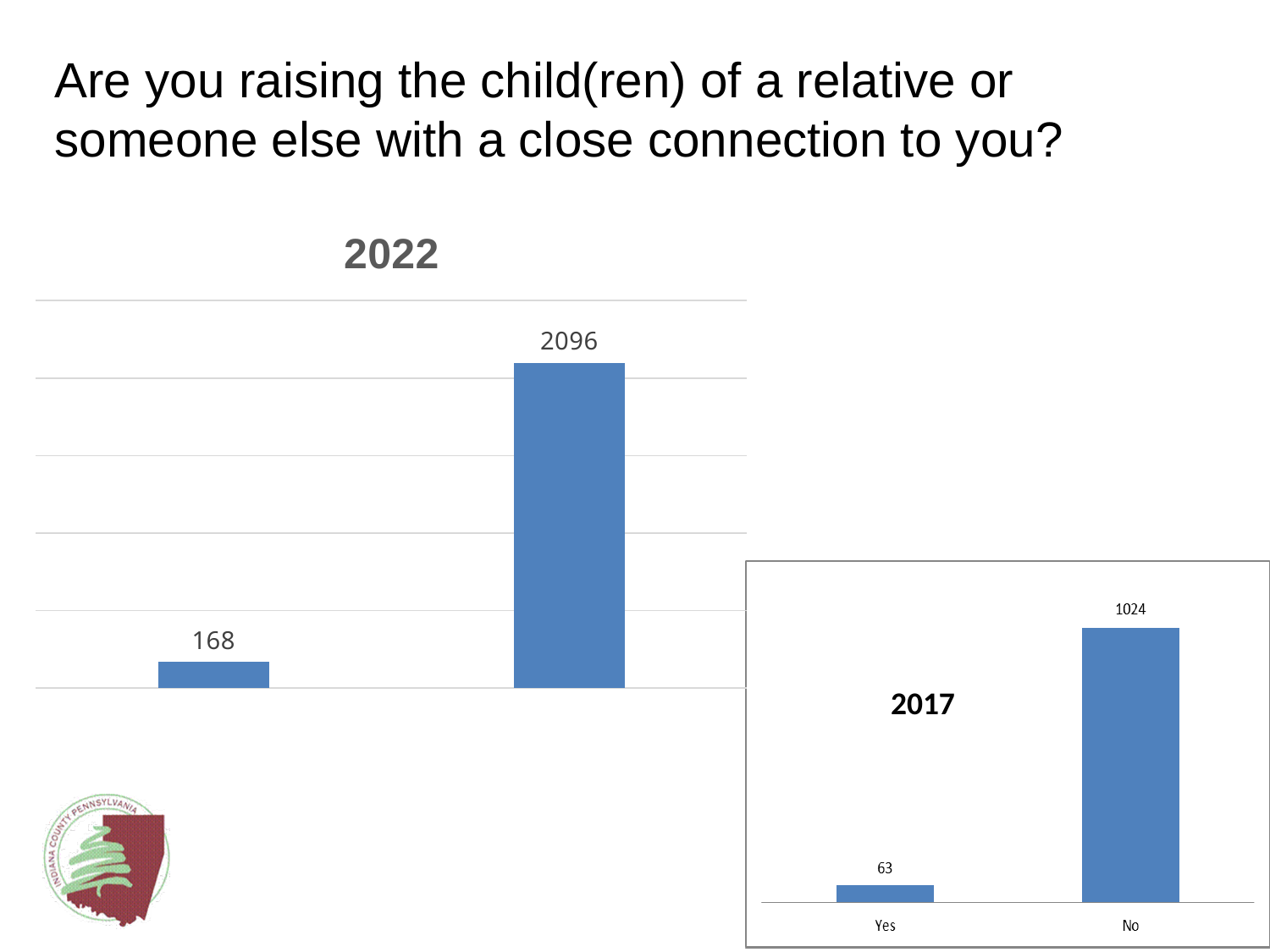
In the 2017 chart, which category has the higher value, Yes or No? No In the 2022 chart, what is the value of the left bar? 168 What kind of chart is the 2017 chart? bar chart In the 2017 chart, what is the difference between the No and Yes values? 961 In the 2022 chart, how many bars are plotted? 2 In the 2017 chart, how many categories are shown on the x axis? 2 In the 2022 chart, what is the value of the shortest bar? 168 In the 2017 chart, what is the value for Yes? 63 In the 2022 chart, what is the difference between the two bar values? 1928 In the 2022 chart, what is the value of the tallest bar? 2096 In the 2017 chart, what is the value for No? 1024 How many charts are shown on the slide? 2